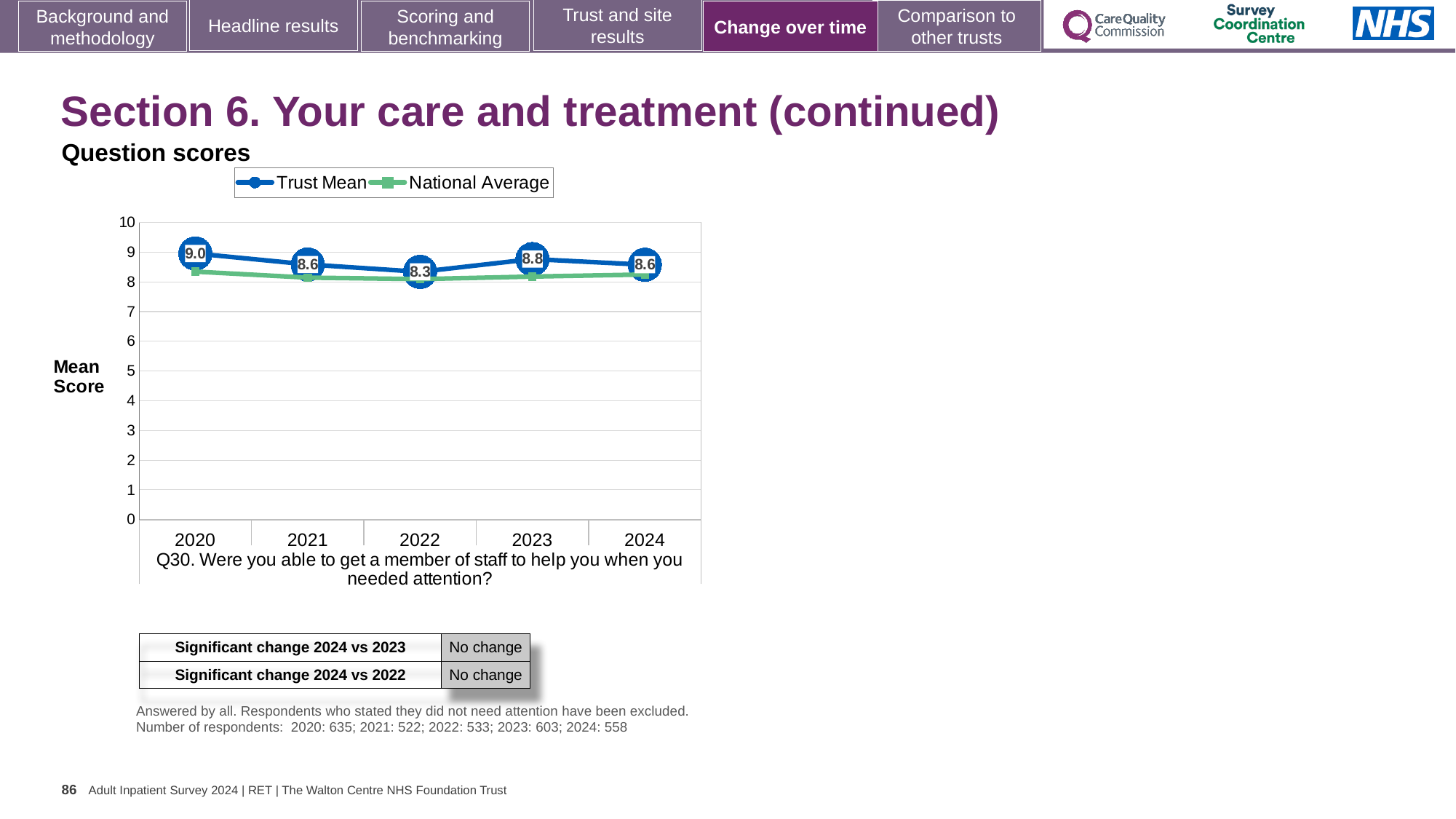
What is the Trust Mean score for 2022? 8.3 Which year has the larger Trust Mean, 2021 or 2023? 2023 What kind of chart is shown? Line chart Does the Trust Mean rise or fall from 2020 to 2022? Fall How many years are plotted on the x axis? 5 What is the Trust Mean score for 2020? 9.0 How many series does the legend list? 2 What is the Trust Mean score for 2024? 8.6 In which year is the Trust Mean highest? 2020 Is the National Average value for 2022 greater or less than 9? less What is the difference between the Trust Mean in 2020 and in 2022? 0.7 In which year is the Trust Mean lowest? 2022